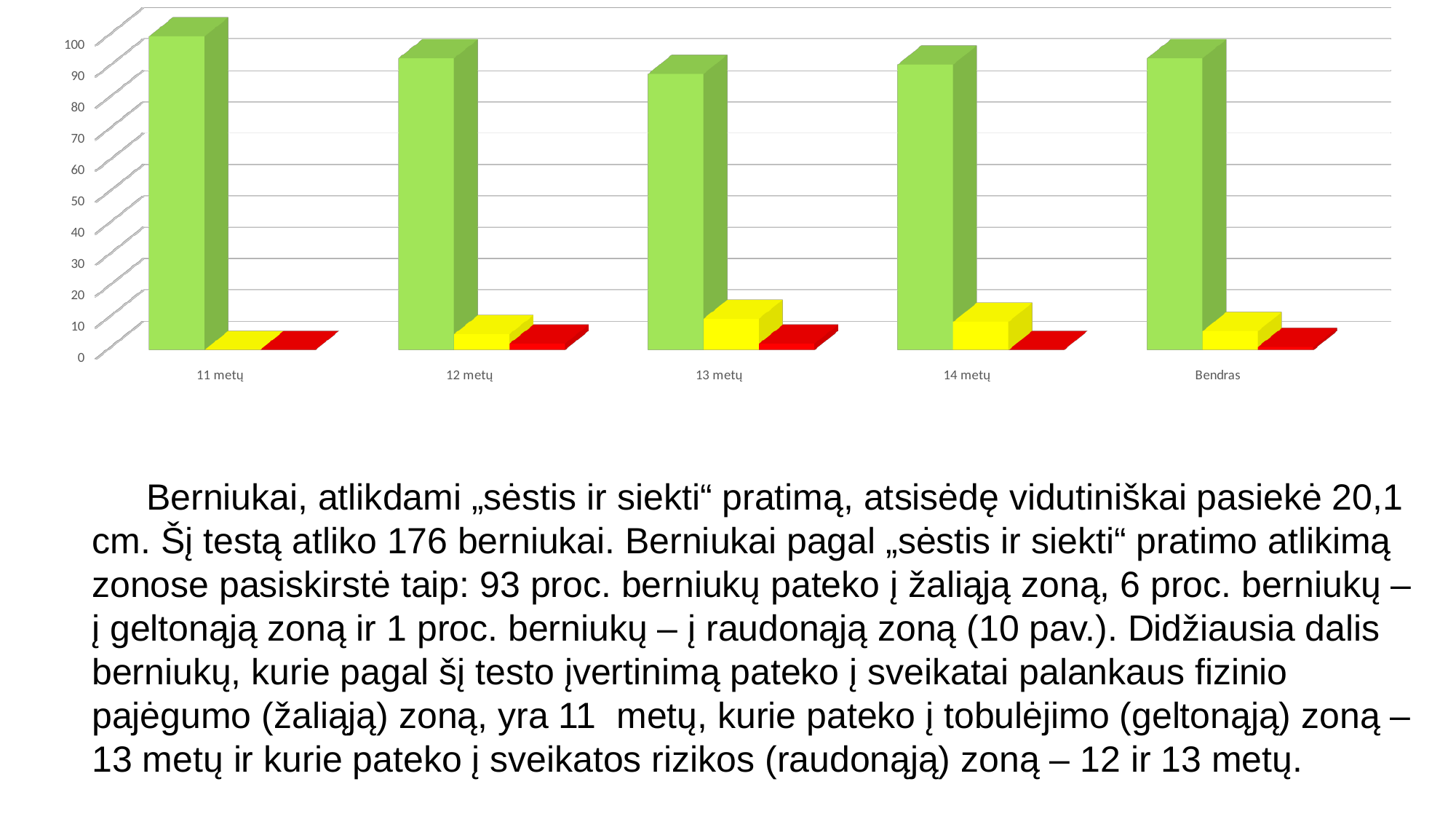
Which is larger, the yellow bar for 13 metų or the yellow bar for 11 metų? 13 metų Which category has the tallest green bar? 11 metų What kind of chart is shown on the slide? bar chart Is the green bar for 11 metų greater or less than 90? greater Which is larger, the yellow bar for 13 metų or the yellow bar for 12 metų? 13 metų How many categories are shown along the x axis of the chart? 5 What three colours are used for the bars in the chart? green, yellow and red Is the red bar for 13 metų greater or less than 10? less Is the green bar for 12 metų greater or less than 80? greater Which is larger, the green bar for 11 metų or the green bar for 13 metų? 11 metų How many bars are plotted for each category in the chart? 3